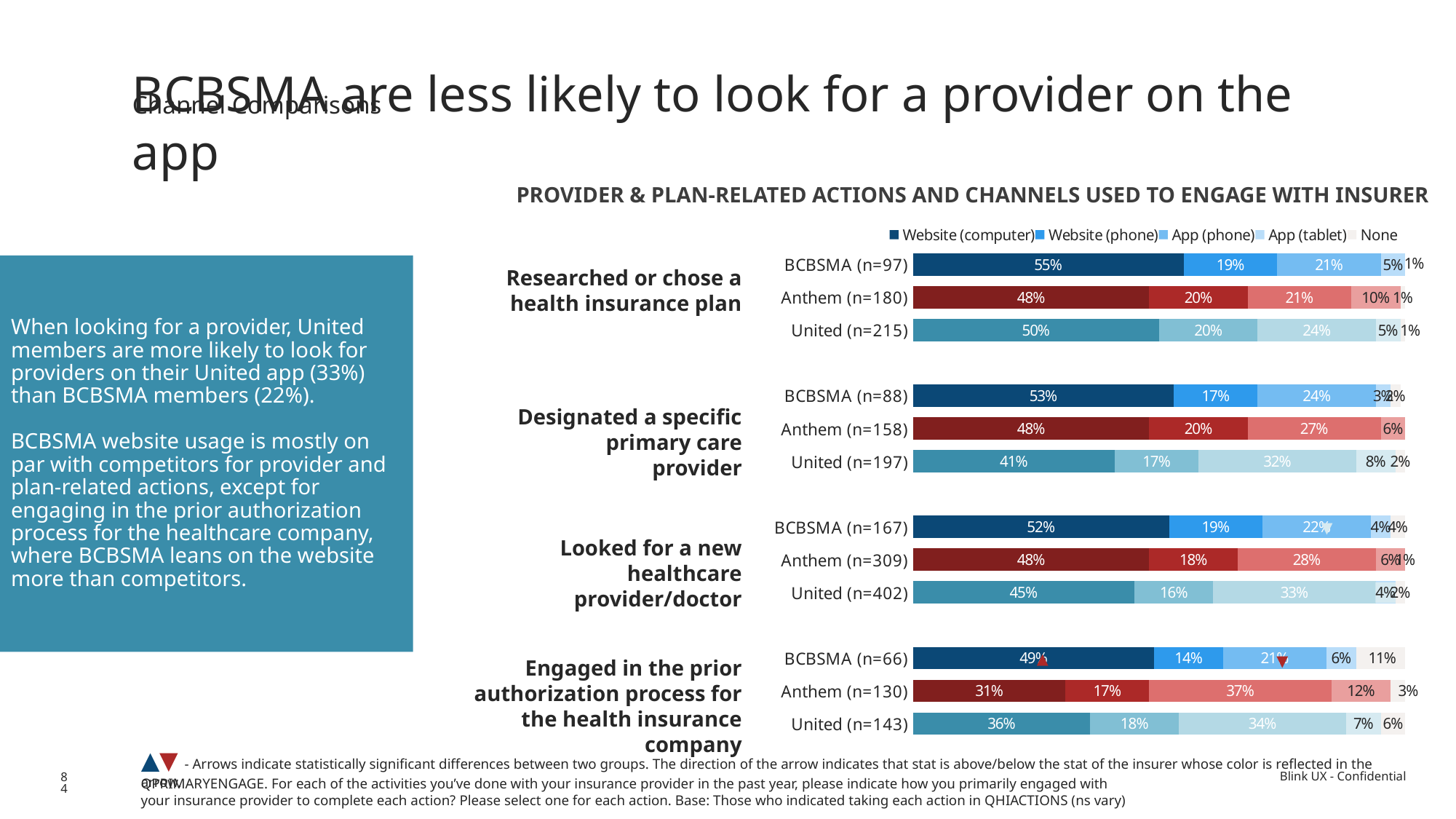
How many series does the chart legend list? 5 What is the difference between the App (phone) values for United (n=402) and BCBSMA (n=167) under 'Looked for a new healthcare provider/doctor'? 11 percentage points What is the Website (computer) value for Anthem (n=130) under 'Engaged in the prior authorization process for the health insurance company'? 31% Which insurer has the highest Website (computer) share for 'Designated a specific primary care provider'? BCBSMA (n=88) What is the None value for BCBSMA (n=66) under 'Engaged in the prior authorization process for the health insurance company'? 11% Which insurer has the lowest Website (computer) share for 'Engaged in the prior authorization process for the health insurance company'? Anthem (n=130) What is the title of the chart? PROVIDER & PLAN-RELATED ACTIONS AND CHANNELS USED TO ENGAGE WITH INSURER Under 'Designated a specific primary care provider', which is larger: the App (phone) value for United (n=197) or for Anthem (n=158)? United (n=197) How many bars are plotted in the chart in total? 12 What kind of chart is shown on the slide? Stacked bar chart What is the Website (computer) value for BCBSMA (n=97) under 'Researched or chose a health insurance plan'? 55% What is the App (phone) value for United (n=402) under 'Looked for a new healthcare provider/doctor'? 33%